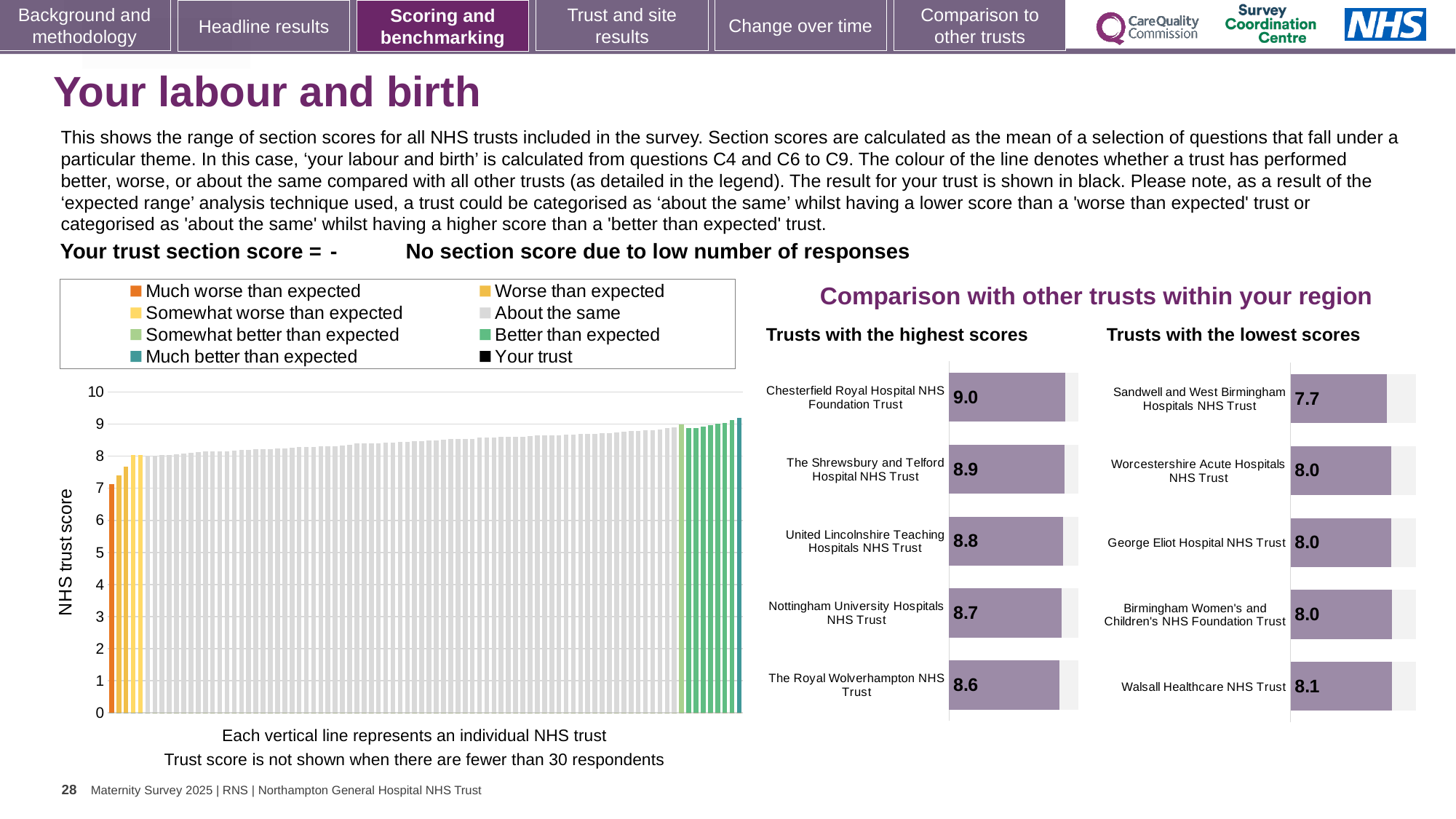
How many trusts are shown in the 'Trusts with the lowest scores' chart? 5 In the large 'NHS trust score' chart on the left, is the value for the rightmost bar greater or less than 8? greater How many entries does the legend above the large 'NHS trust score' chart list? 8 In the large 'NHS trust score' chart on the left, do the bar values rise or fall from left to right? rise In the 'Trusts with the lowest scores' chart, what is the score for Sandwell and West Birmingham Hospitals NHS Trust? 7.7 In the 'Trusts with the highest scores' chart, what is the difference between the scores of Chesterfield Royal Hospital NHS Foundation Trust and The Royal Wolverhampton NHS Trust? 0.4 In the 'Trusts with the lowest scores' chart, which has the larger score: Walsall Healthcare NHS Trust or Sandwell and West Birmingham Hospitals NHS Trust? Walsall Healthcare NHS Trust In the 'Trusts with the lowest scores' chart, what is the score for Walsall Healthcare NHS Trust? 8.1 In the 'Trusts with the highest scores' chart, which trust has the highest score? Chesterfield Royal Hospital NHS Foundation Trust In the 'Trusts with the lowest scores' chart, which trust has the lowest score? Sandwell and West Birmingham Hospitals NHS Trust In the 'Trusts with the highest scores' chart, what is the score for Chesterfield Royal Hospital NHS Foundation Trust? 9.0 In the 'Trusts with the highest scores' chart, what is the score for The Royal Wolverhampton NHS Trust? 8.6